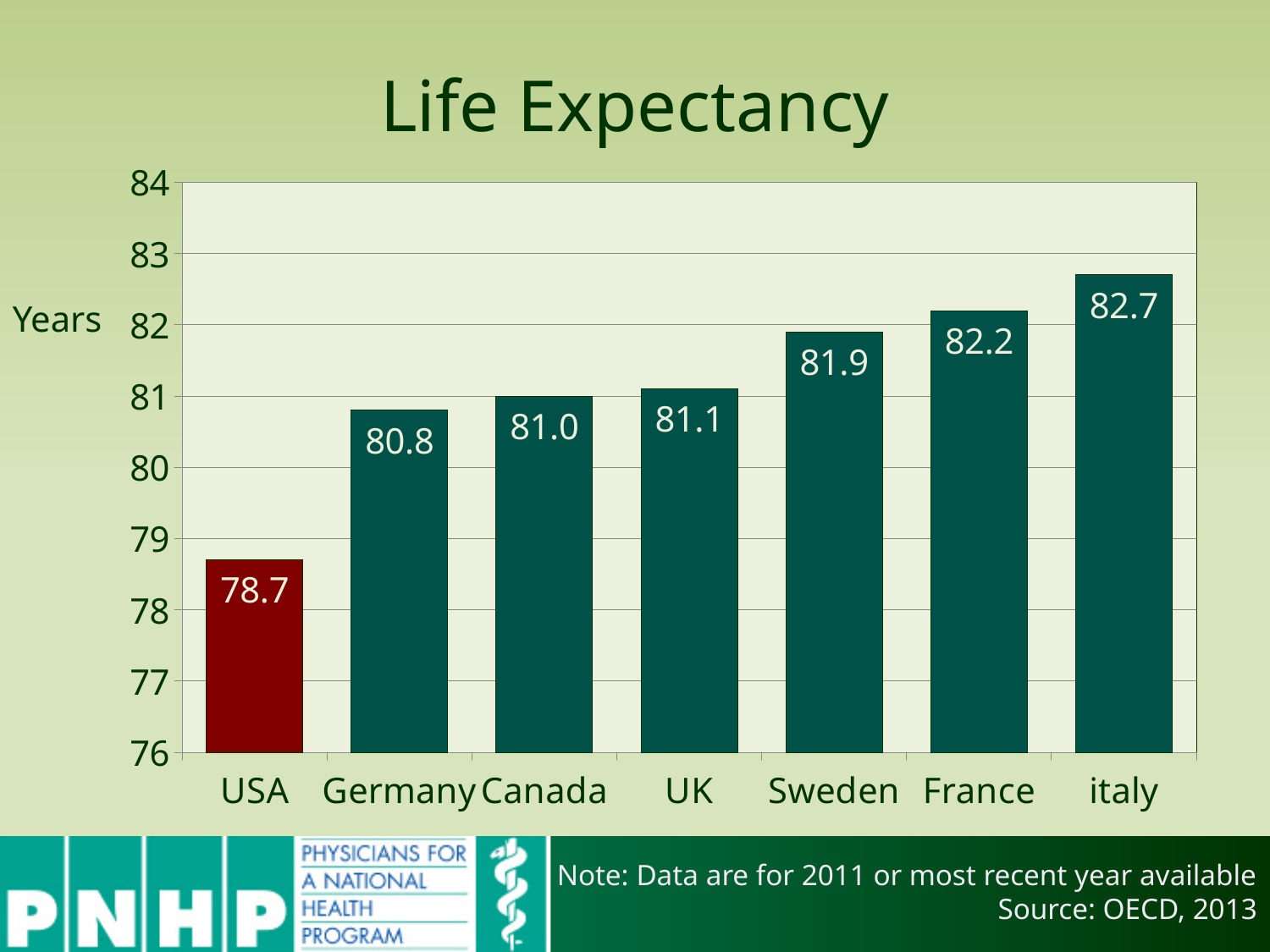
What is the difference between the life expectancy of France and the UK? 1.1 What kind of chart is shown on the slide? bar chart What is the life expectancy value shown for the USA? 78.7 Which has a higher life expectancy, Canada or Sweden? Sweden Is the value for the USA greater or less than 79? less How many countries are shown on the chart? 7 What is the life expectancy value shown for Germany? 80.8 What is the difference between the life expectancy of Italy and the USA? 4.0 Which bar is coloured differently (red) from the others? USA What is the life expectancy value shown for Sweden? 81.9 Which country has the lowest life expectancy on the chart? USA Which country has the highest life expectancy on the chart? italy